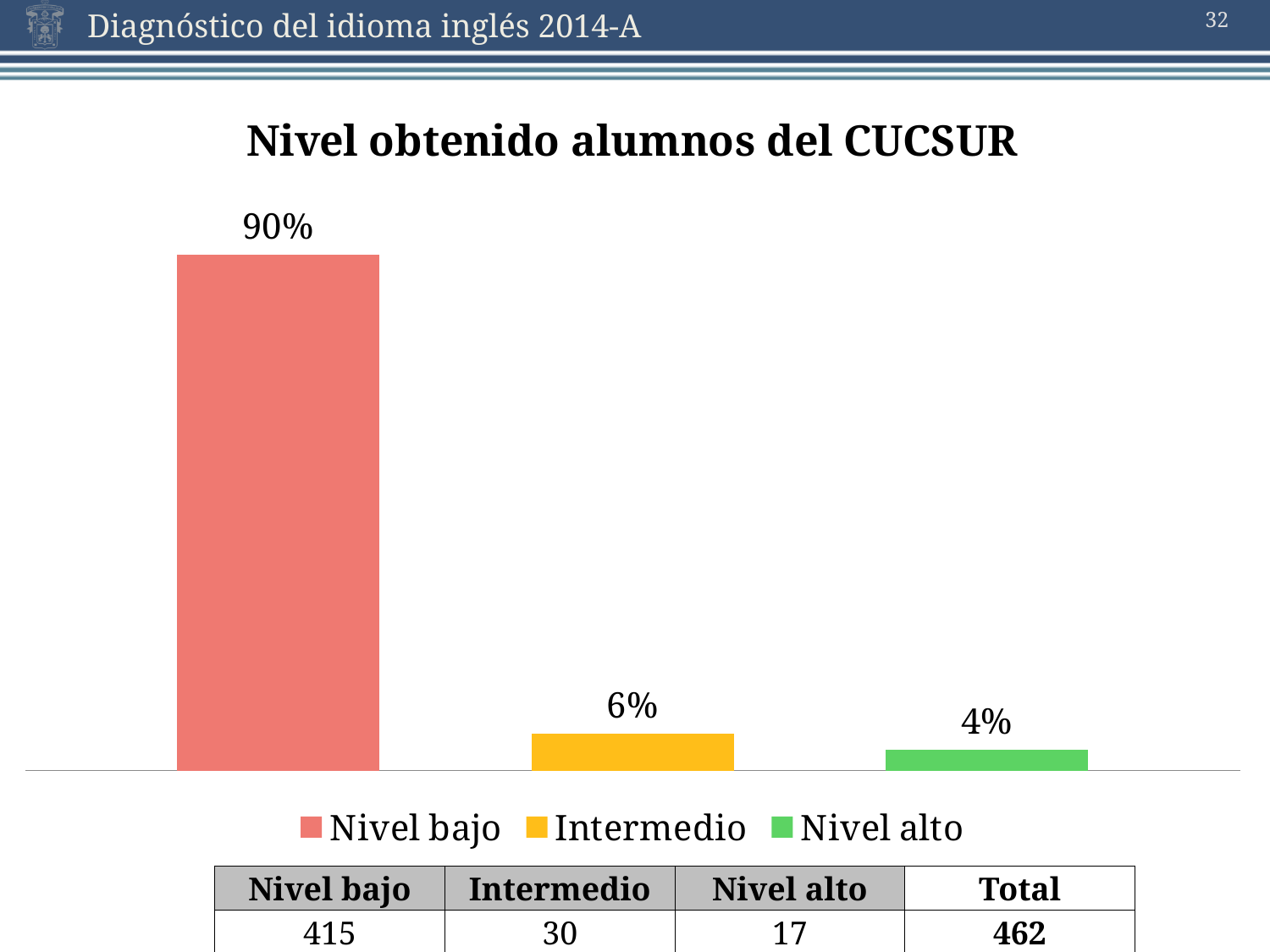
What is the difference in percentage points between Nivel bajo and Intermedio? 84 What percentage is shown for Intermedio? 6% How many bars are plotted in the chart? 3 What percentage is shown for Nivel bajo? 90% What is the title of the chart? Nivel obtenido alumnos del CUCSUR How many series does the legend list? 3 What is the difference in percentage points between Intermedio and Nivel alto? 2 What kind of chart is shown on the slide? Bar chart Which level has the lowest percentage? Nivel alto Which level has the highest percentage? Nivel bajo Which is larger, the value for Intermedio or the value for Nivel alto? Intermedio What percentage is shown for Nivel alto? 4%